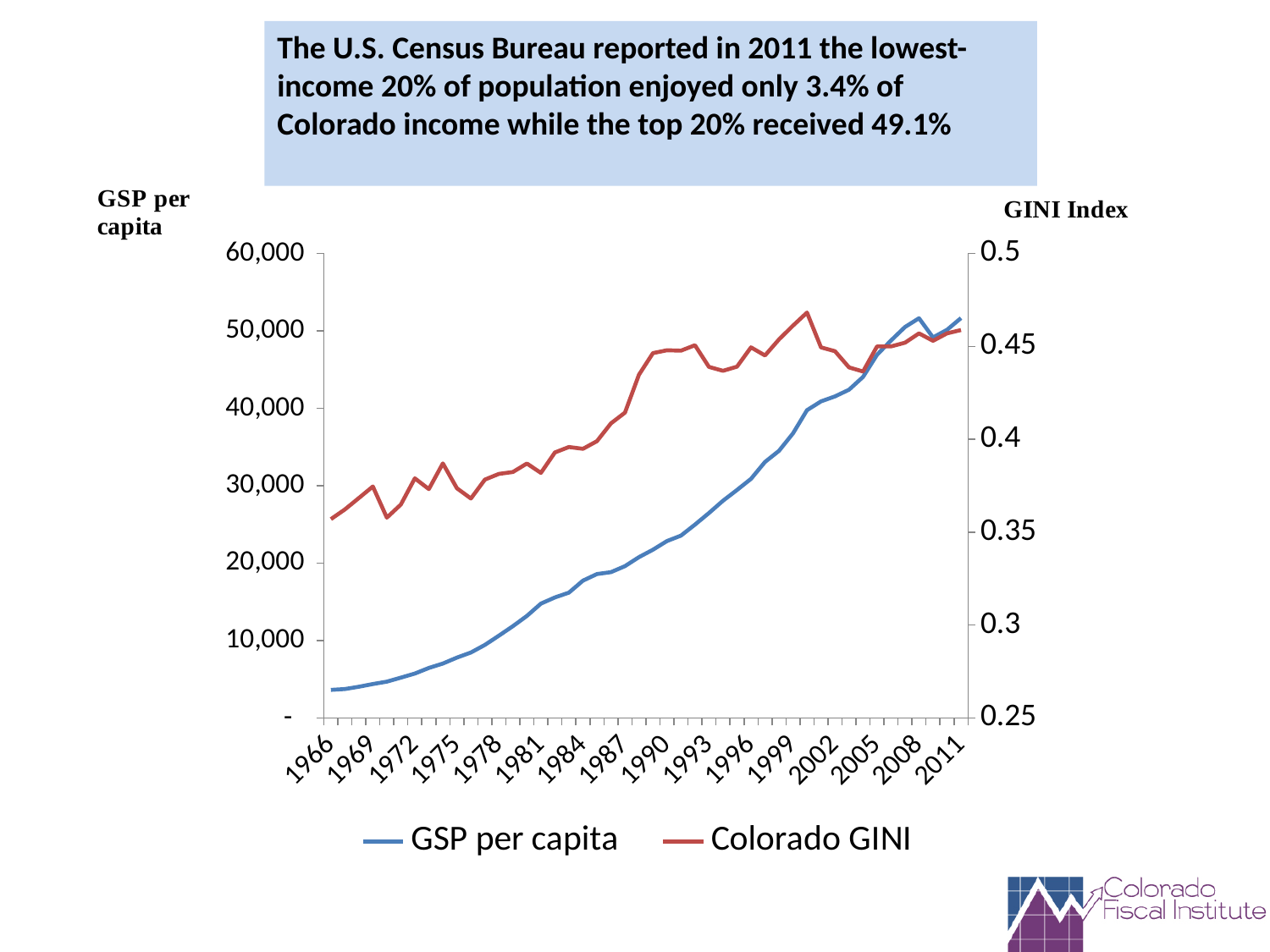
Is the value for GSP per capita in 1984 greater or less than 20,000? less Is the value for GSP per capita in 1966 greater or less than 10,000? less Is the value for GSP per capita in 1990 greater or less than 30,000? less What is the title of the right-hand vertical axis? GINI Index How many series does the legend list? 2 What are the two series named in the legend? GSP per capita and Colorado GINI What kind of chart is shown on the slide? line chart Does GSP per capita generally rise or fall from 1966 to 2011? rise How many year labels are shown on the x axis? 16